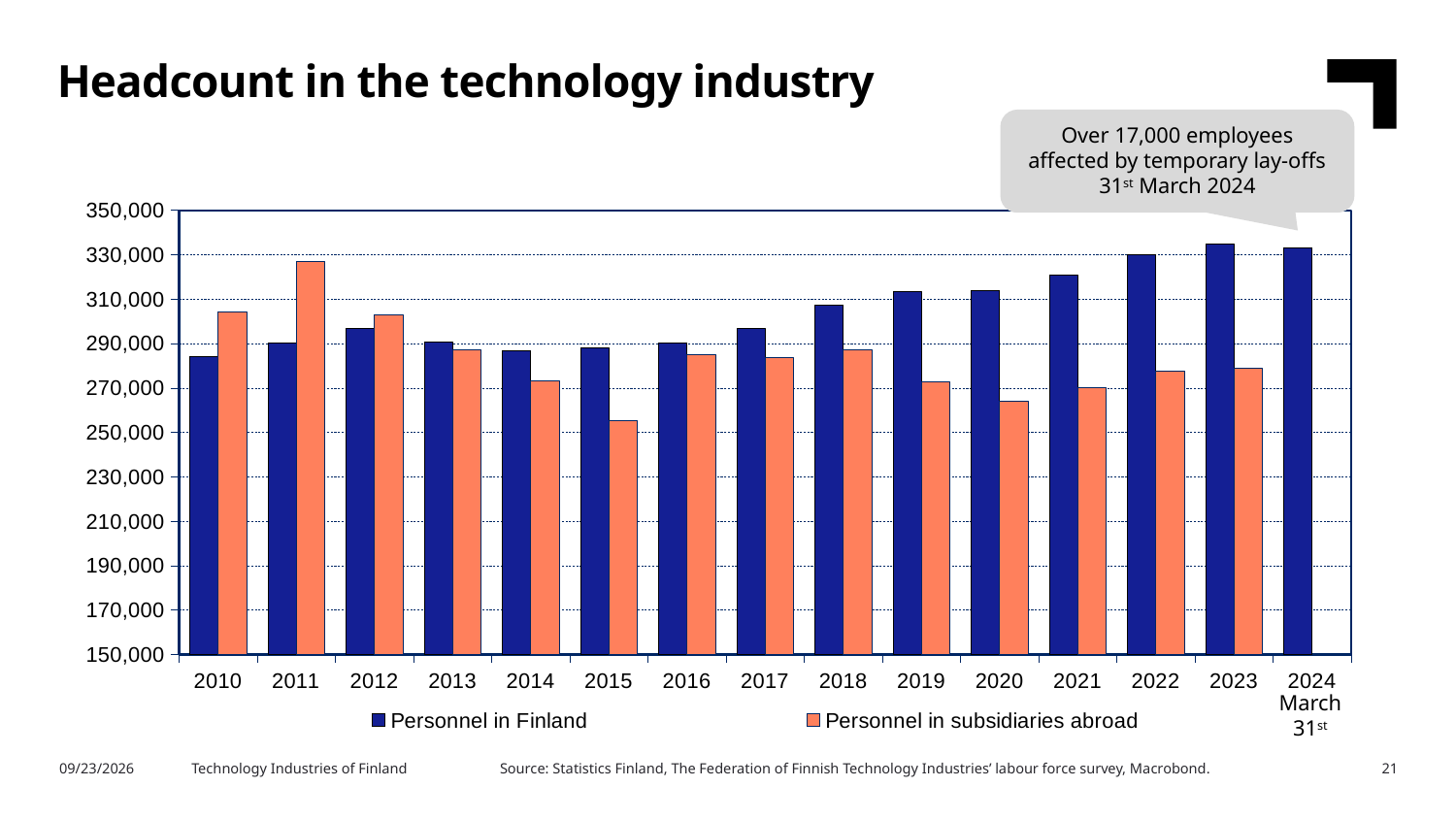
In 2010, which is larger: Personnel in Finland or Personnel in subsidiaries abroad? Personnel in subsidiaries abroad In 2019, which is larger: Personnel in Finland or Personnel in subsidiaries abroad? Personnel in Finland Is the value for Personnel in Finland in 2022 greater or less than 310,000? greater How many series does the legend list? 2 Is the value for Personnel in Finland in 2010 greater or less than 290,000? less Is the value for Personnel in subsidiaries abroad in 2011 greater or less than 310,000? greater In which year is the value for Personnel in subsidiaries abroad the highest? 2011 How many year categories are shown on the x axis? 15 Does the value for Personnel in Finland rise or fall from 2017 to 2023? rise What kind of chart is shown on the slide? bar chart In which year is the value for Personnel in subsidiaries abroad the lowest? 2015